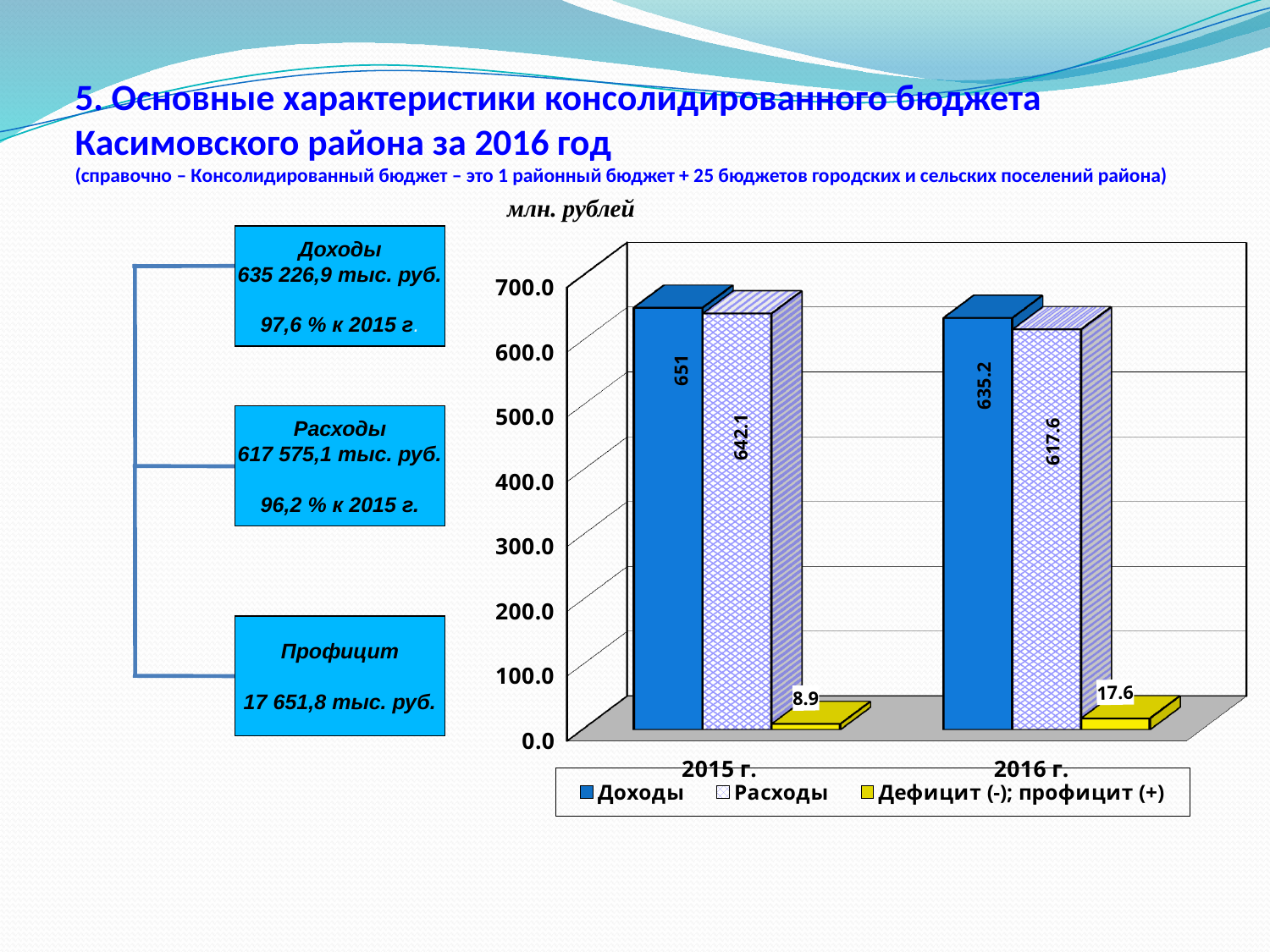
What kind of chart is shown on the slide? bar chart What is the value of Дефицит (-); профицит (+) for 2015 г.? 8.9 Does the value of Дефицит (-); профицит (+) rise or fall from 2015 г. to 2016 г.? rise What unit is indicated above the chart? млн. рублей What is the value of Доходы for 2015 г.? 651 What is the value of Расходы for 2016 г.? 617.6 What is the difference between Доходы in 2015 г. and Доходы in 2016 г.? 15.8 What is the value of Доходы for 2016 г.? 635.2 Which year has the higher value for Расходы? 2015 г. What is the difference between Доходы and Расходы in 2016 г.? 17.6 How many categories are shown on the x axis? 2 How many series does the legend list? 3